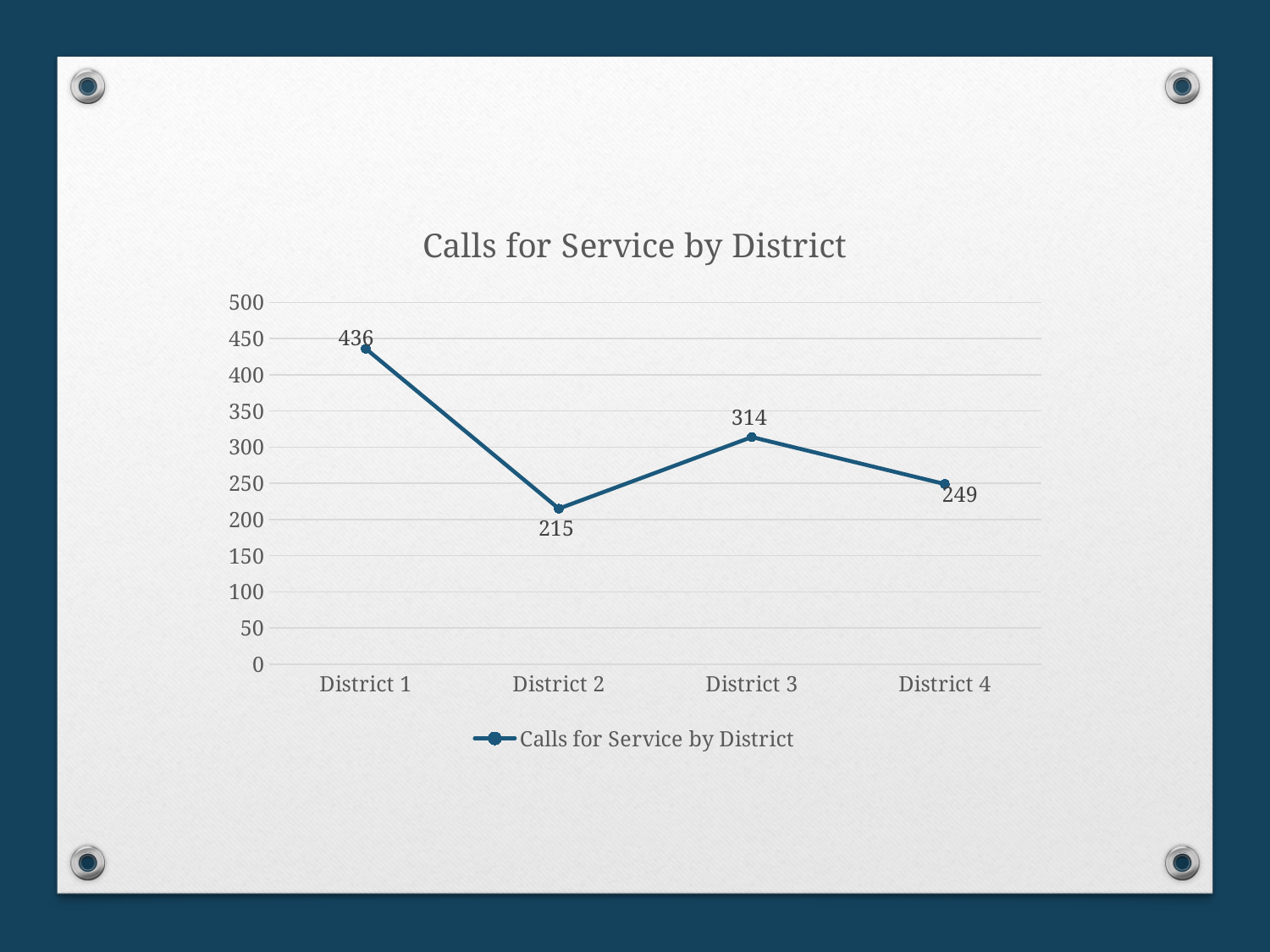
What is the value for District 1? 436 What kind of chart is shown on the slide? Line chart What is the difference between the values for District 3 and District 4? 65 What is the value for District 3? 314 What is the value for District 4? 249 Which district has the lowest number of calls for service? District 2 What is the value for District 2? 215 What is the title of the chart? Calls for Service by District Which is larger, the value for District 3 or District 4? District 3 What is the difference between the values for District 1 and District 2? 221 How many districts are plotted on the chart? 4 Which district has the highest number of calls for service? District 1